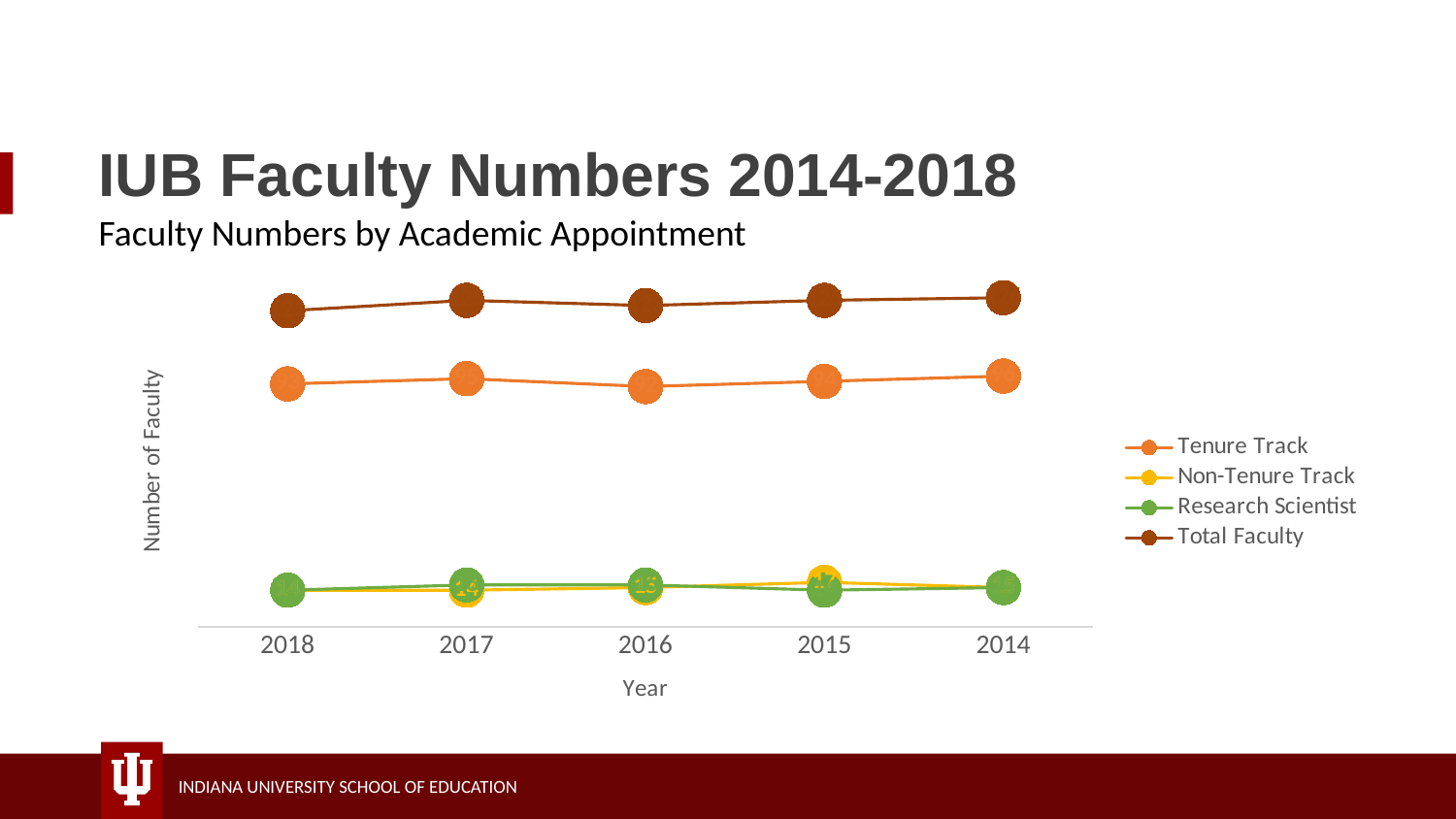
What is the label of the y axis? Number of Faculty In 2018, which is larger: Total Faculty or Tenure Track? Total Faculty Which year is the leftmost category on the x axis? 2018 How many years are shown on the x axis? 5 In 2016, which is larger: Tenure Track or Research Scientist? Tenure Track How many series does the legend list? 4 What kind of chart is shown on the slide? line chart What is the title of the chart? Faculty Numbers by Academic Appointment Which series has the highest values across all years? Total Faculty In 2014, which is larger: Non-Tenure Track or Total Faculty? Total Faculty